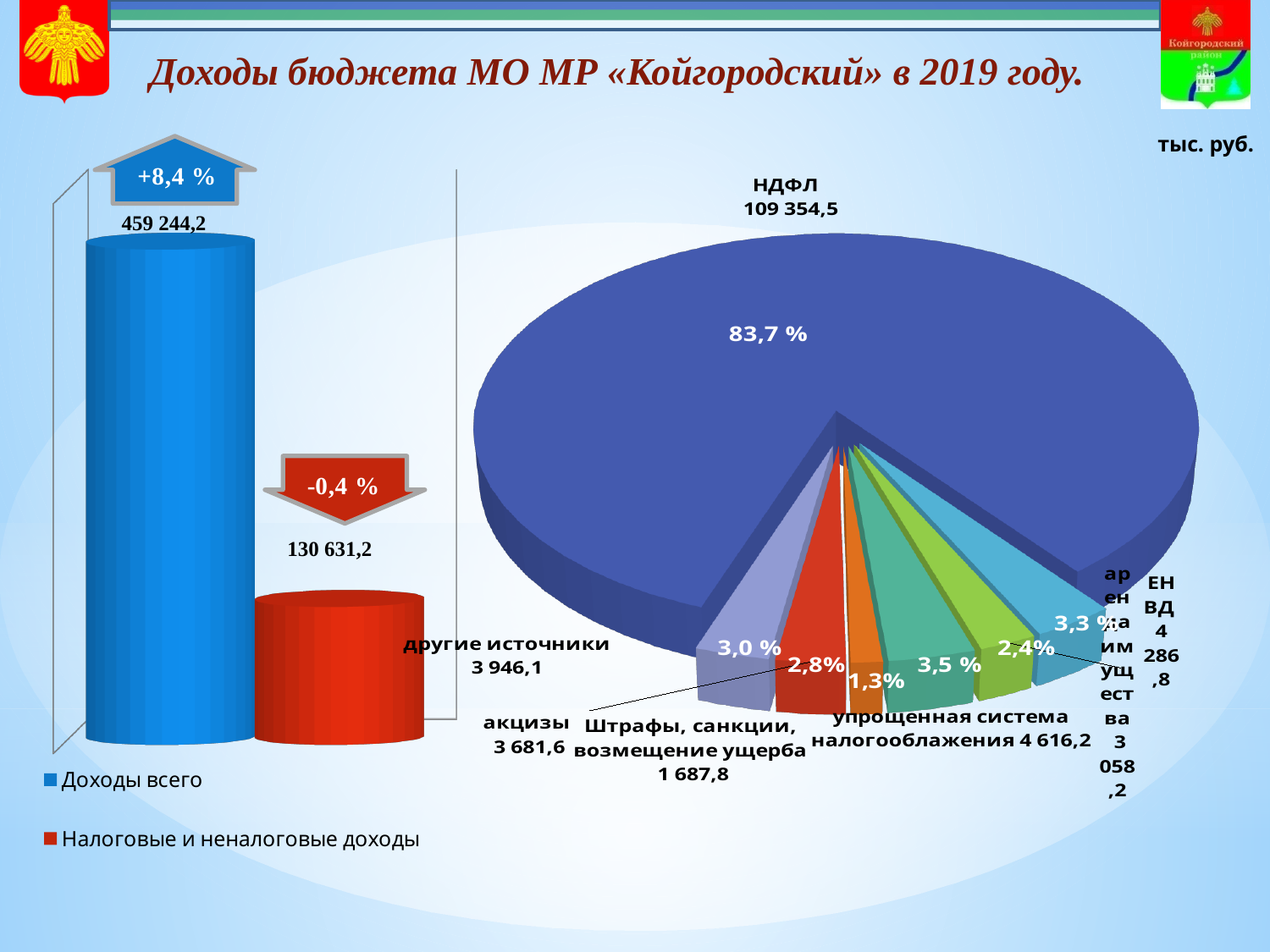
On the bar chart on the left, how many series does the legend list? 2 On the pie chart on the right, what is the value for «упрощенная система налогооблажения»? 4 616,2 On the pie chart on the right, what share of the pie does НДФЛ take? 83,7 % On the bar chart on the left, what percentage change is shown above the «Доходы всего» bar? +8,4 % On the pie chart on the right, how many slices are there? 7 What kind of chart is shown on the left of the slide? bar chart On the pie chart on the right, which slice is the smallest? Штрафы, санкции, возмещение ущерба On the bar chart on the left, what is the value for «Доходы всего»? 459 244,2 On the bar chart on the left, which of the two bars is larger, «Доходы всего» or «Налоговые и неналоговые доходы»? Доходы всего On the pie chart on the right, what is the value for НДФЛ? 109 354,5 On the bar chart on the left, what is the difference between «Доходы всего» and «Налоговые и неналоговые доходы»? 328 613,0 On the bar chart on the left, what is the value for «Налоговые и неналоговые доходы»? 130 631,2